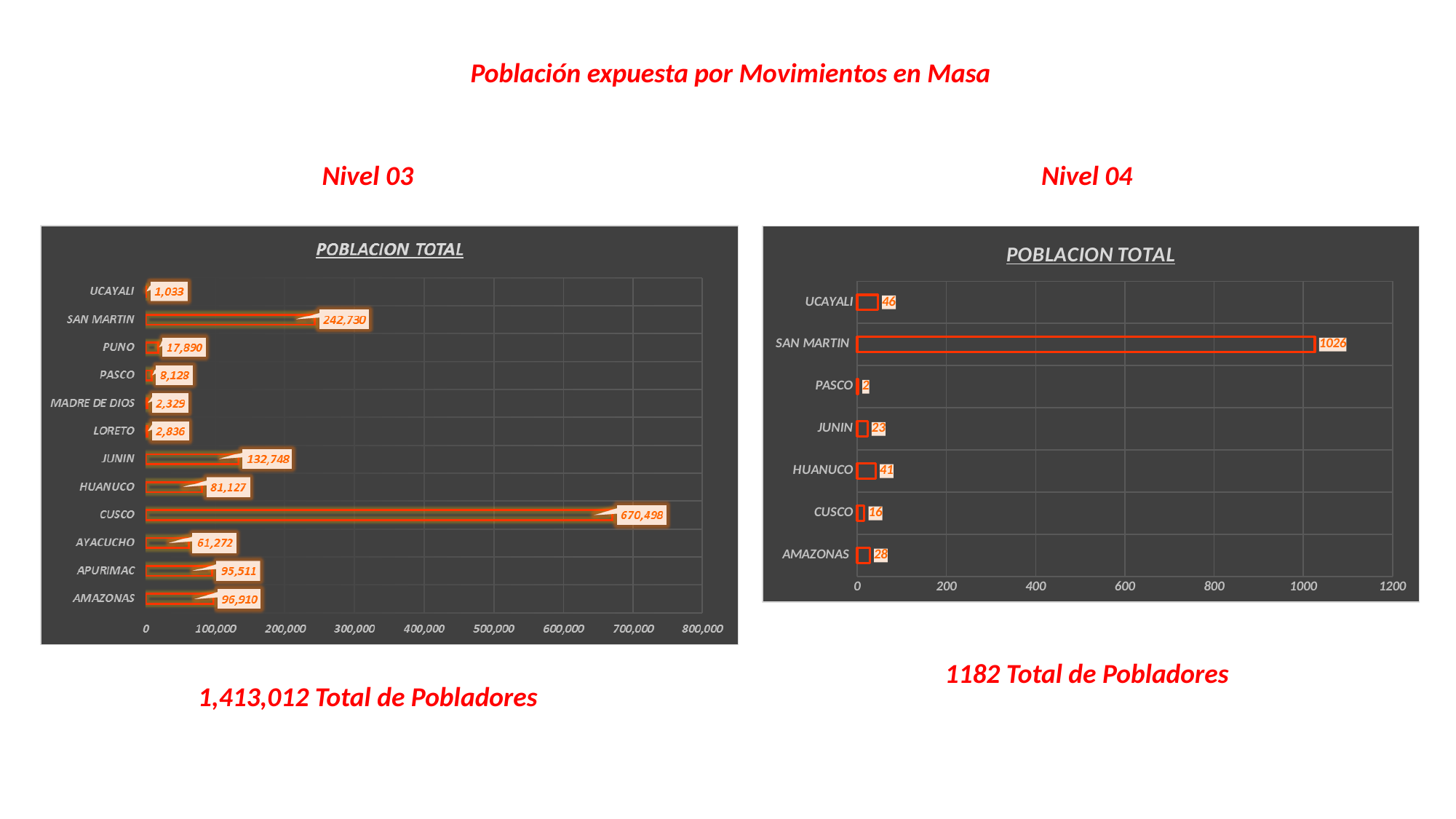
In the Nivel 04 chart on the right, which region has the lowest value? PASCO In the Nivel 04 chart on the right, what is the difference between the values for SAN MARTIN and UCAYALI? 980 In the Nivel 04 chart on the right, what is the value for SAN MARTIN? 1026 In the Nivel 03 chart on the left, what is the difference between the values for CUSCO and SAN MARTIN? 427,768 What type of chart is the Nivel 04 chart on the right? Bar chart How many regions are shown in the Nivel 04 chart on the right? 7 In the Nivel 04 chart on the right, is the value for SAN MARTIN greater or less than 1000? greater How many regions are shown in the Nivel 03 chart on the left? 12 In the Nivel 03 chart on the left, which is larger, the value for JUNIN or the value for HUANUCO? JUNIN In the Nivel 03 chart on the left, which region has the highest value? CUSCO In the Nivel 03 chart on the left, which region has the lowest value? UCAYALI In the Nivel 03 chart on the left, what is the value for CUSCO? 670,498